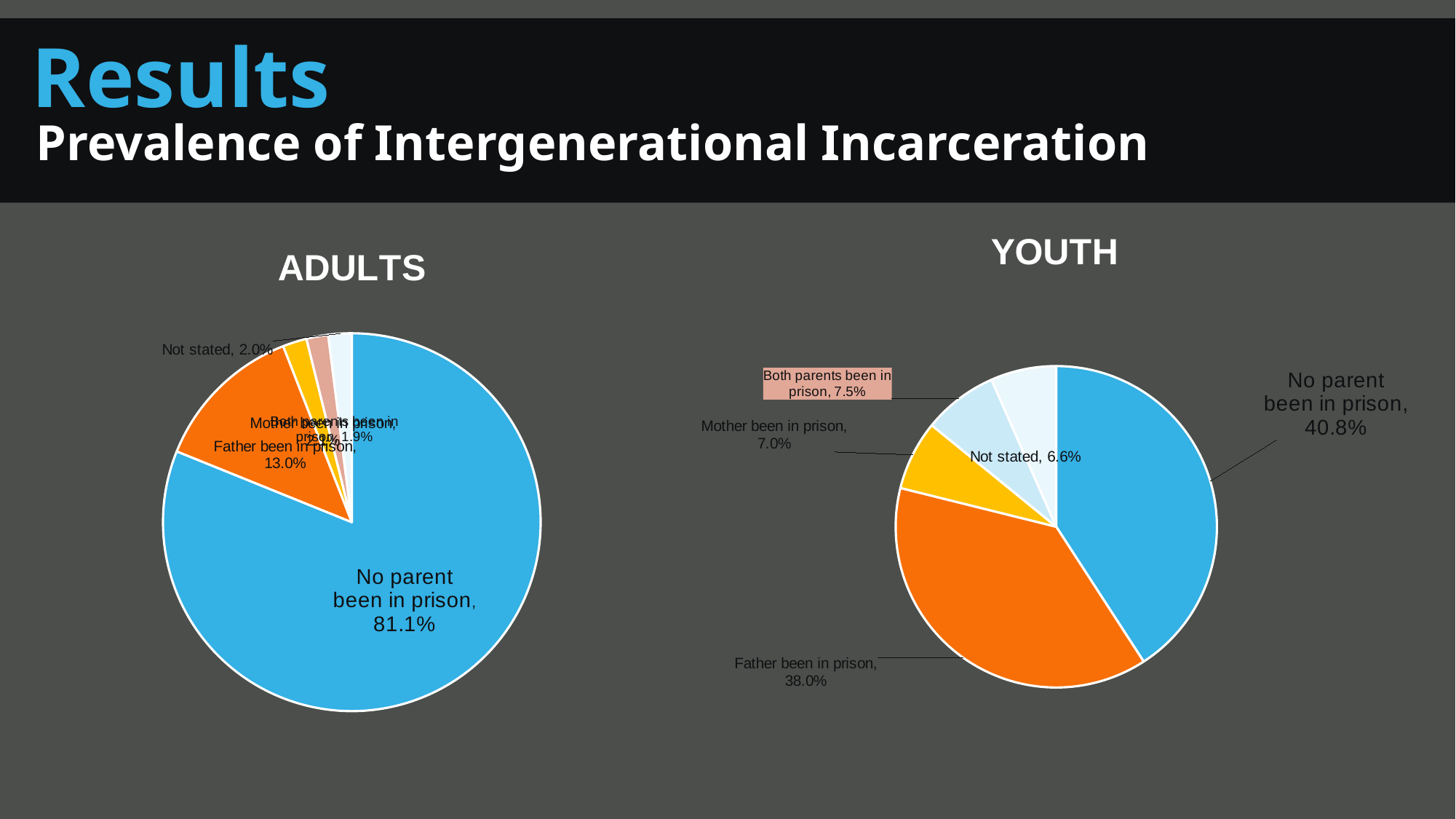
In the ADULTS pie chart, what is the value for 'Not stated'? 2.0% In the YOUTH pie chart, what is the value for 'Mother been in prison'? 7.0% In the ADULTS pie chart, what percentage of adults had no parent been in prison? 81.1% In the ADULTS pie chart, what is the share for 'Father been in prison'? 13.0% In the YOUTH pie chart, which category has the largest slice? No parent been in prison What type of chart is used for the ADULTS data? Pie chart In the YOUTH pie chart, which category has the smallest slice? Not stated In the YOUTH pie chart, what is the difference between 'No parent been in prison' and 'Father been in prison'? 2.8% Which is larger: 'Father been in prison' for adults or 'Father been in prison' for youth? Youth In the YOUTH pie chart, what is the share for 'Father been in prison'? 38.0% In the YOUTH pie chart, what is the value for 'Both parents been in prison'? 7.5% In the YOUTH pie chart, what percentage of youth had no parent been in prison? 40.8%